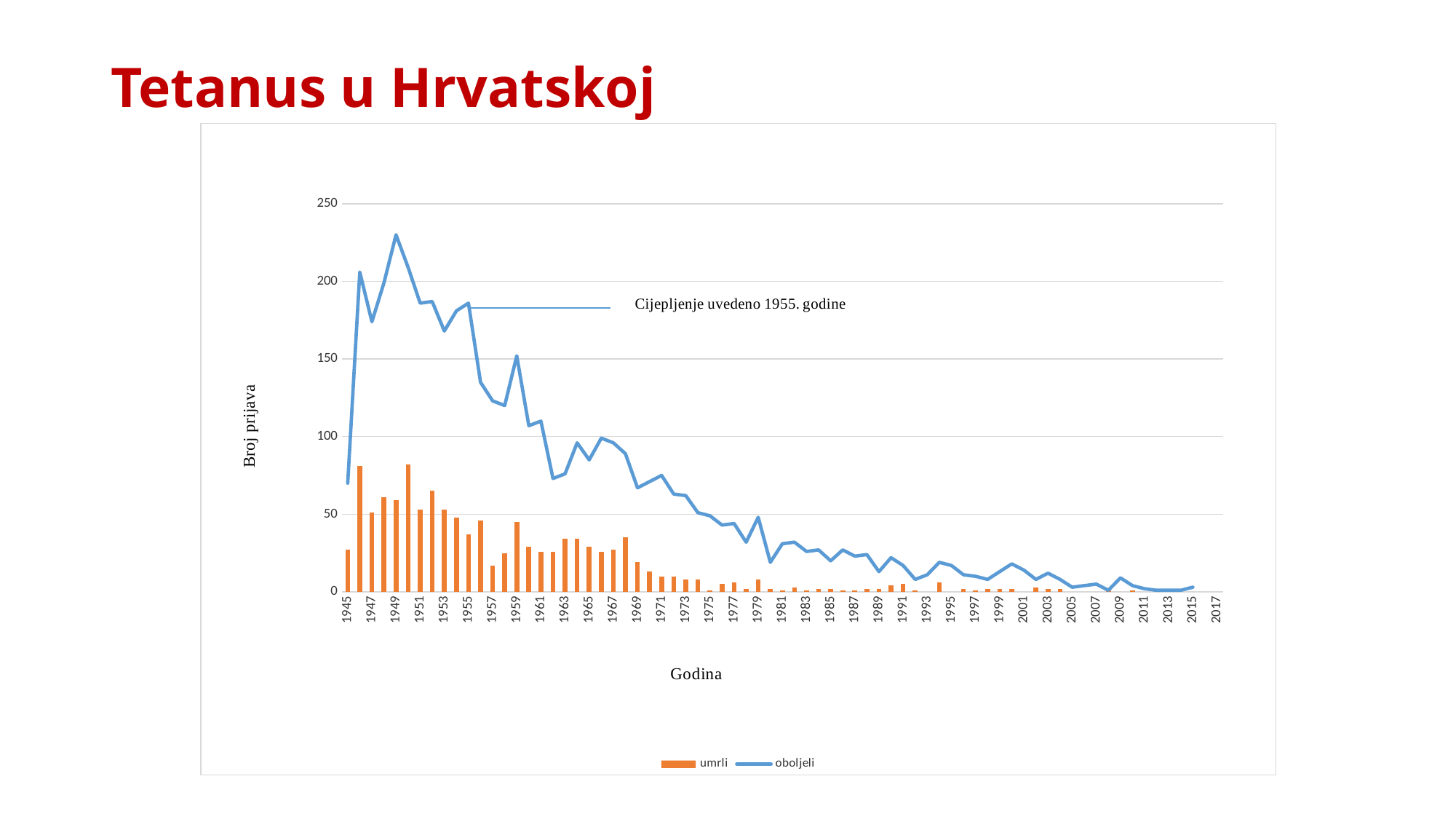
What is the title of the vertical axis? Broj prijava What is the overall trend of the oboljeli line from 1949 to 2015? Falling Which year has the larger oboljeli value, 1949 or 1959? 1949 Is the oboljeli value for 1949 greater or less than 200? greater Is the oboljeli value for 1945 greater or less than 100? less How many series does the chart legend list? 2 Is the umrli value for 1955 greater or less than 50? less What kind of chart is shown on the slide? A combined bar and line chart What text does the annotation on the chart say? Cijepljenje uvedeno 1955. godine In which year does the oboljeli line reach its highest value? 1949